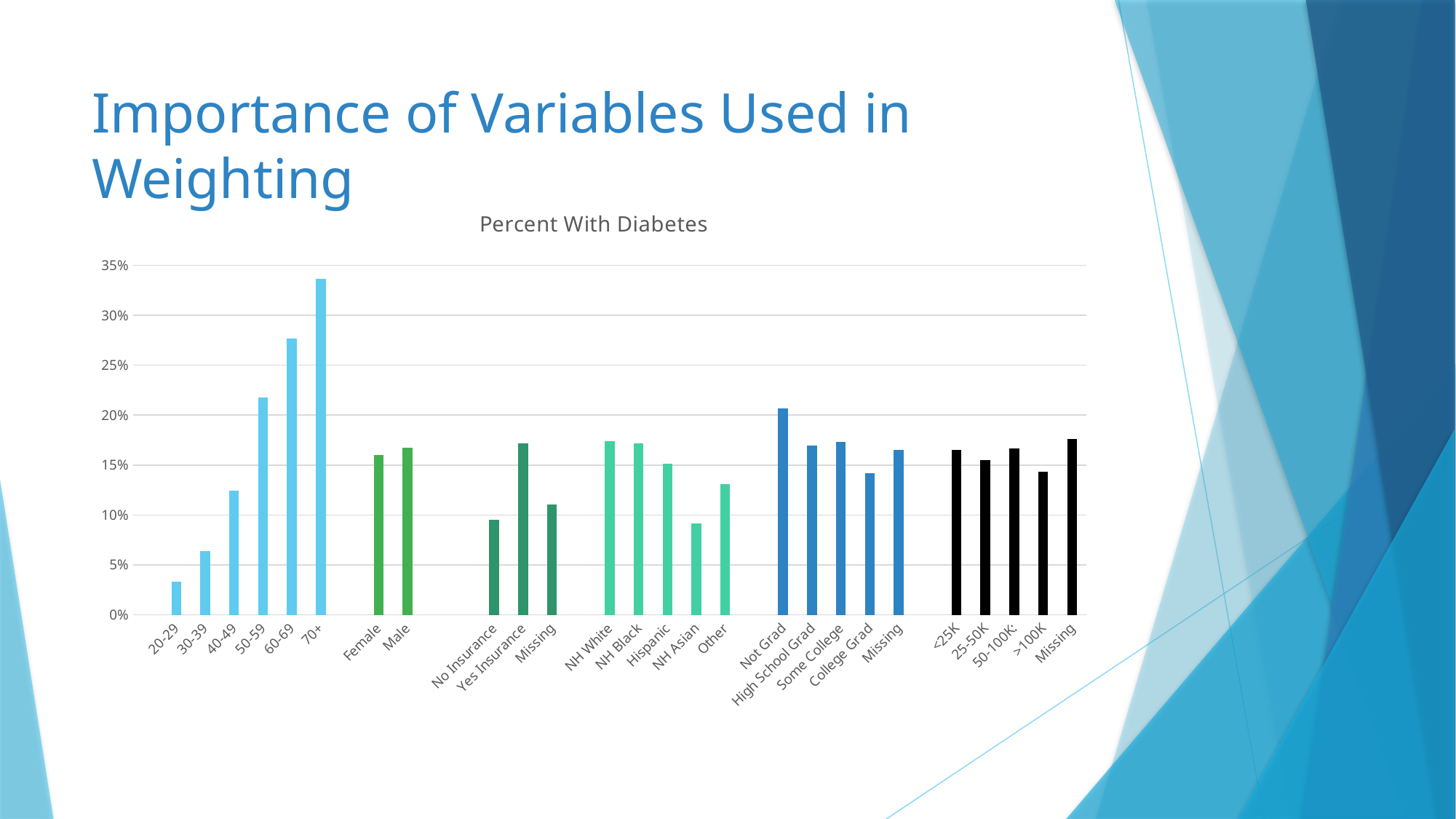
Which category has the lowest percent with diabetes? 20-29 Is the value for 70+ greater or less than 30%? greater Is the value for No Insurance greater or less than 10%? less Which category has the highest percent with diabetes? 70+ Is the value for 20-29 greater or less than 5%? less Which is larger, the value for Yes Insurance or the value for No Insurance? Yes Insurance What kind of chart is shown on the slide? bar chart Which is larger, the value for NH White or the value for NH Asian? NH White What is the title of the chart? Percent With Diabetes Do the values rise or fall across the age groups from 20-29 to 70+? rise